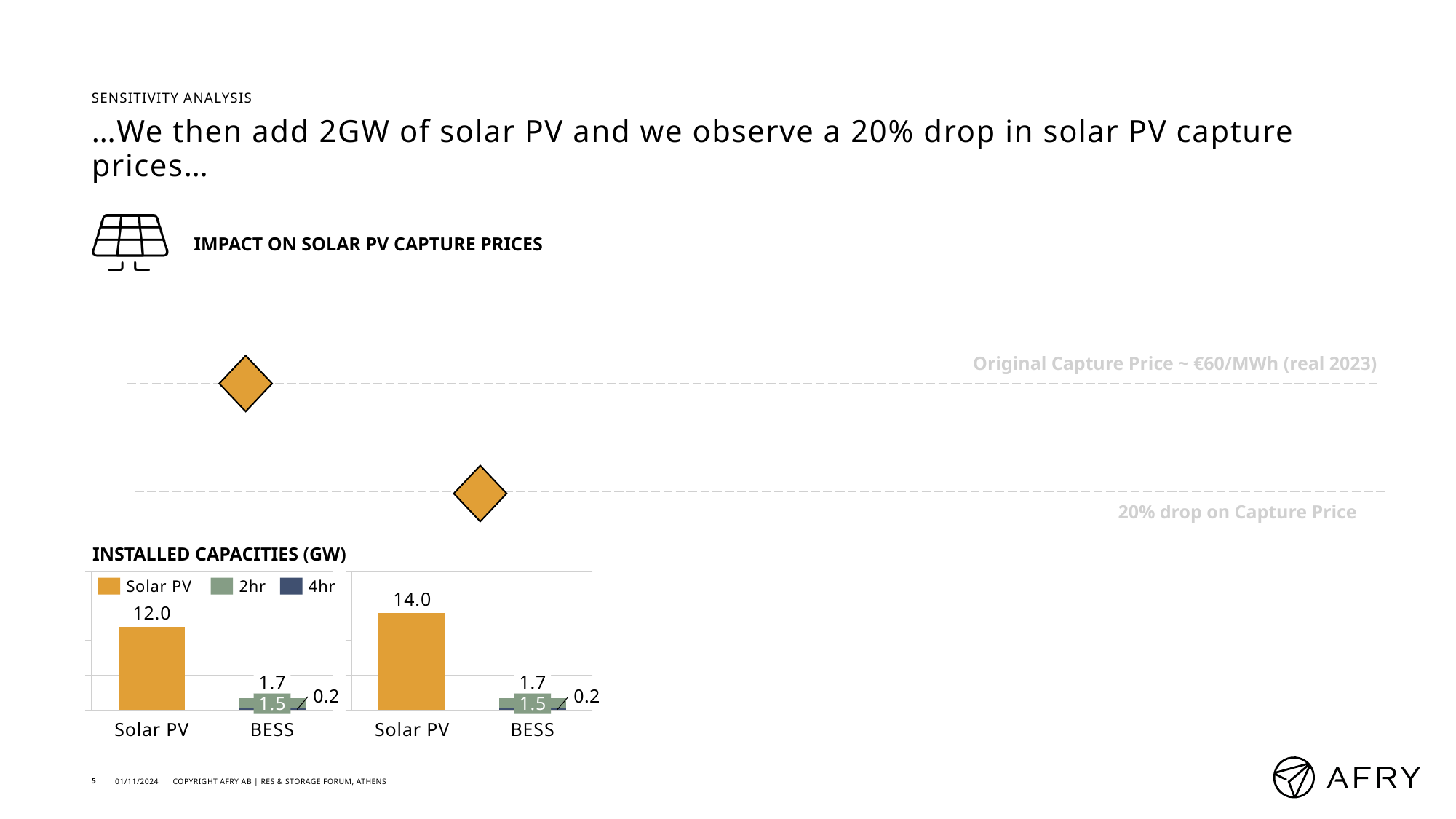
In the left installed capacities chart, which category is highest? Solar PV In the left installed capacities chart, what is the total of the BESS stacked bar? 1.7 What is the difference between the Solar PV values in the right and left installed capacities charts? 2.0 In the right installed capacities chart, what is the 2hr value for BESS? 1.5 How many series does the legend of the installed capacities charts list? 3 In the right installed capacities chart, which category is lowest? BESS In the right installed capacities chart, what is the difference between the Solar PV value and the BESS total? 12.3 What kind of chart is used for the installed capacities? Bar chart In the right installed capacities chart, what is the value for Solar PV? 14.0 What unit is given in the title of the installed capacities charts? GW In the left installed capacities chart, what is the 4hr value for BESS? 0.2 In the left installed capacities chart, what is the value for Solar PV? 12.0